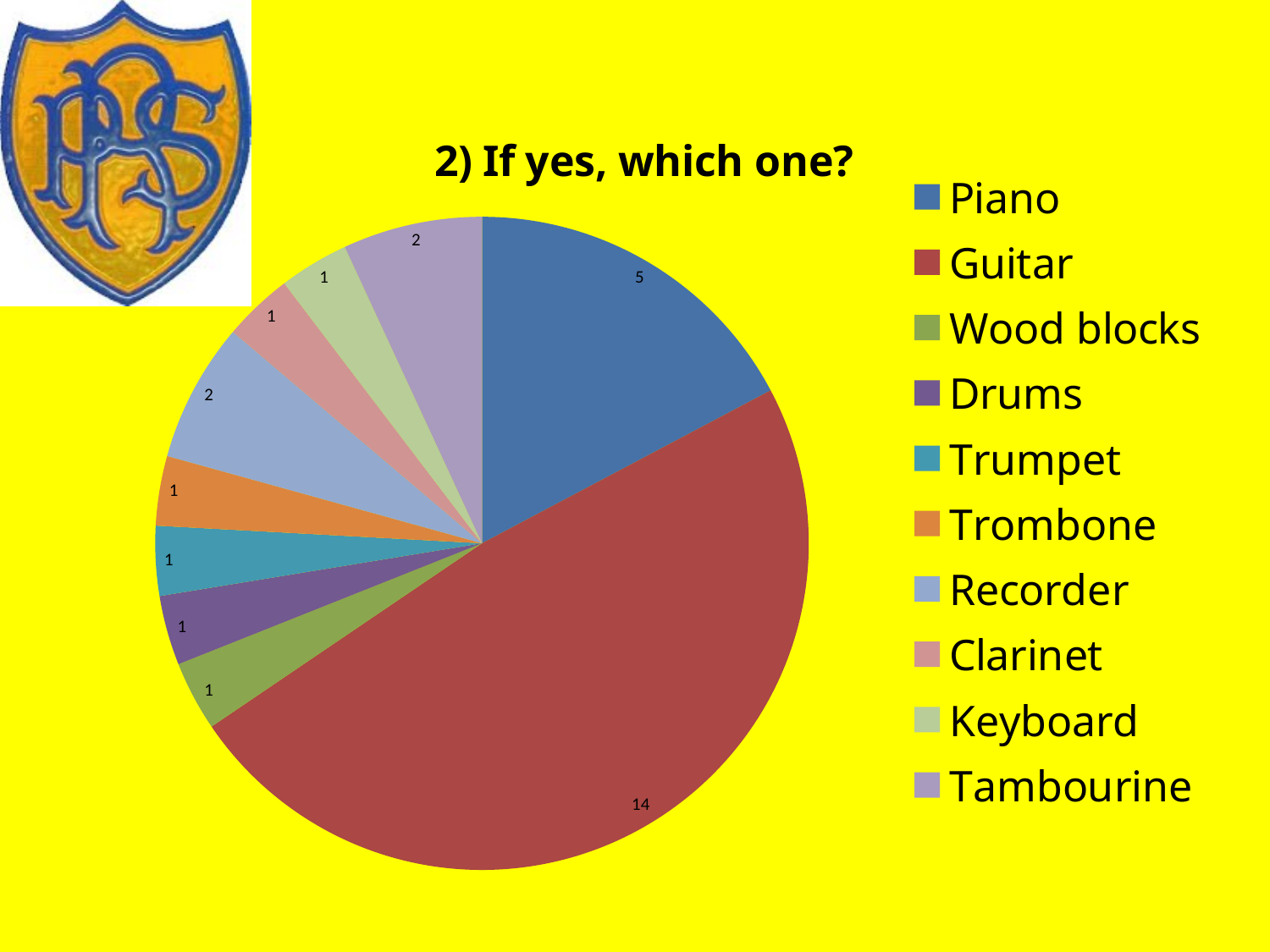
What is the value for Trumpet? 1 What is the value for Recorder? 2 What is the difference between the values for Guitar and Piano? 9 Which is larger, the value for Piano or the value for Recorder? Piano What is the title of the chart? 2) If yes, which one? What type of chart is shown on the slide? Pie chart How many instrument categories are shown in the pie chart? 10 What is the value for Guitar? 14 What is the total of all the values in the pie chart? 29 Which instrument has the largest slice of the pie? Guitar What is the value for Tambourine? 2 What is the value for Piano? 5